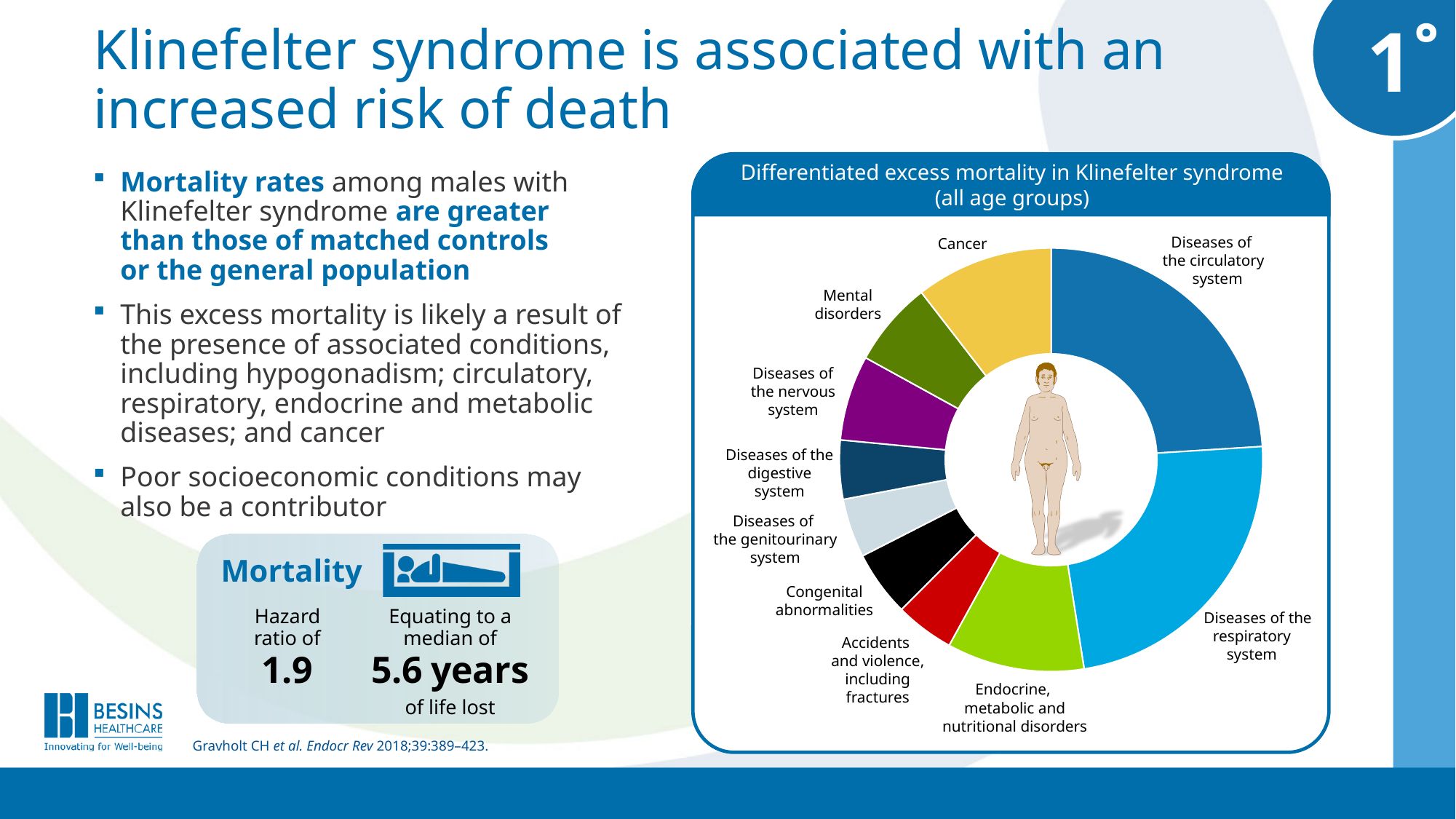
What kind of chart is shown on the slide? Doughnut chart Which slice is larger: Diseases of the nervous system or Diseases of the digestive system? Diseases of the nervous system Which slice is larger: Endocrine, metabolic and nutritional disorders or Accidents and violence, including fractures? Endocrine, metabolic and nutritional disorders How many categories (causes of death) does the pie chart show? 10 What is the title of the pie chart? Differentiated excess mortality in Klinefelter syndrome (all age groups) Which slice is larger: Diseases of the respiratory system or Endocrine, metabolic and nutritional disorders? Diseases of the respiratory system What colour is the Cancer slice in the pie chart? Yellow